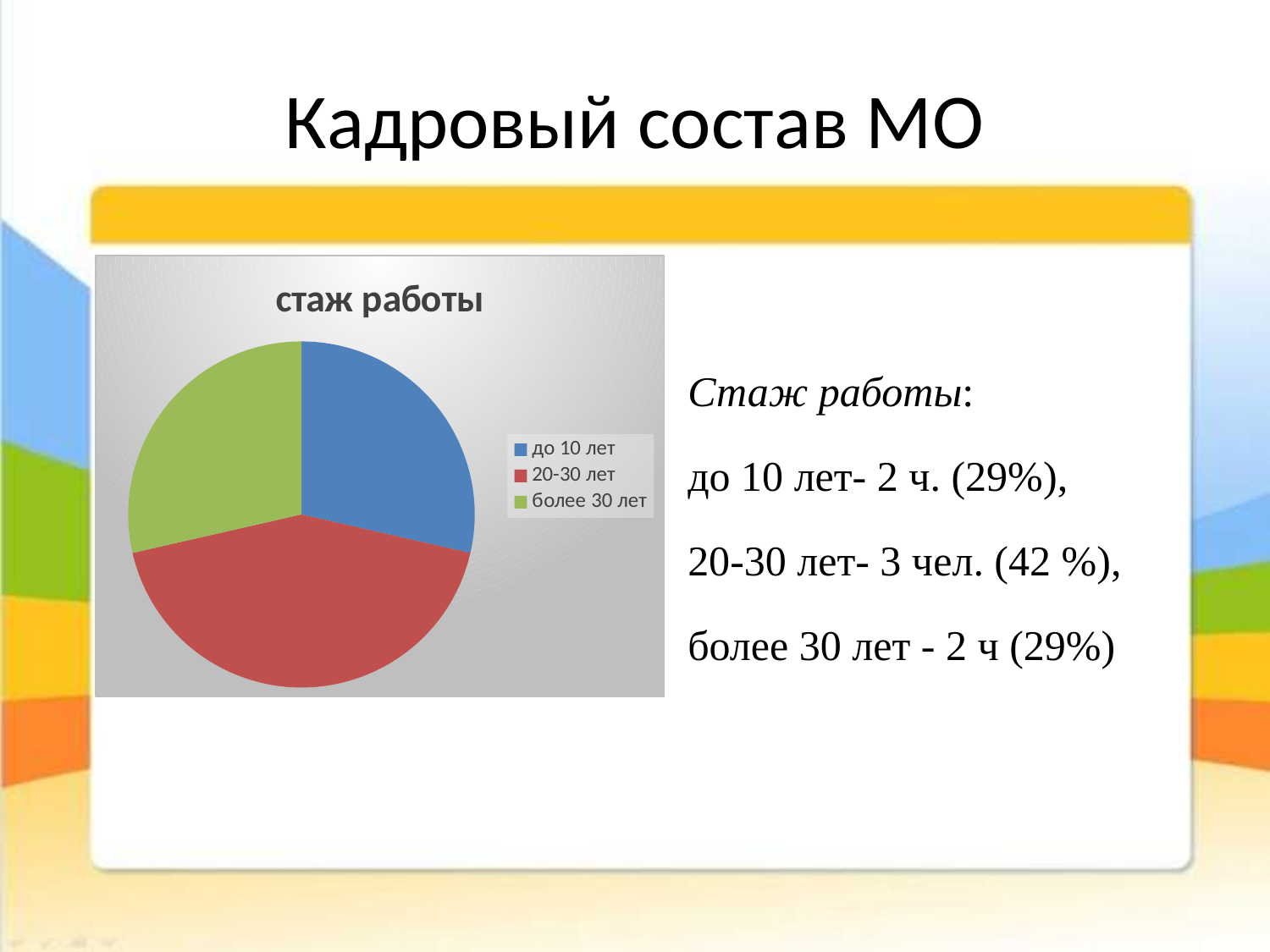
According to the slide, how many people are in the 20-30 лет category? 3 чел. What is the title of the chart? стаж работы Which slice is larger: 20-30 лет or более 30 лет? 20-30 лет According to the slide, what share of the pie does до 10 лет represent? 29% How many slices does the pie chart have? 3 What kind of chart is shown on the slide? pie chart Which slice is larger: 20-30 лет or до 10 лет? 20-30 лет According to the slide, how many people are in the более 30 лет category? 2 ч Which category has the largest slice of the pie? 20-30 лет According to the slide, what share of the pie does 20-30 лет represent? 42 % What colour is the slice for до 10 лет? blue How many entries does the chart legend list? 3